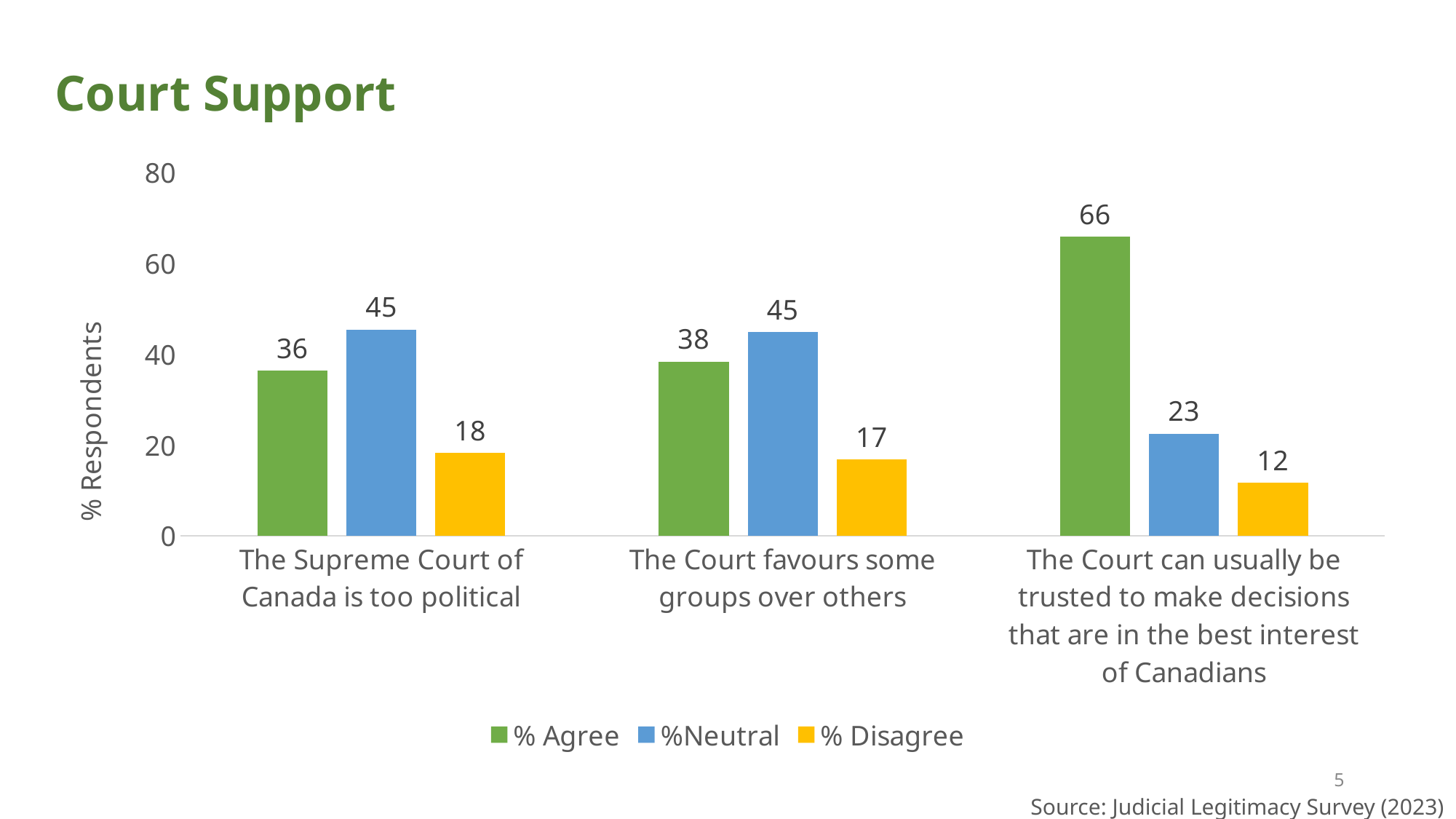
What is the label of the vertical axis? % Respondents For "The Supreme Court of Canada is too political", which is larger: % Agree or %Neutral? %Neutral How many statements (categories) are shown on the x axis? 3 What is the %Neutral value for "The Supreme Court of Canada is too political"? 45 What is the difference between the % Agree and % Disagree values for "The Court can usually be trusted to make decisions that are in the best interest of Canadians"? 54 Which statement has the lowest % Disagree value? The Court can usually be trusted to make decisions that are in the best interest of Canadians What is the difference between the % Agree values for "The Court favours some groups over others" and "The Supreme Court of Canada is too political"? 2 How many series does the legend list? 3 What kind of chart is shown on the slide? Bar chart What is the % Disagree value for "The Court favours some groups over others"? 17 Which statement has the highest % Agree value? The Court can usually be trusted to make decisions that are in the best interest of Canadians What is the % Agree value for "The Court can usually be trusted to make decisions that are in the best interest of Canadians"? 66